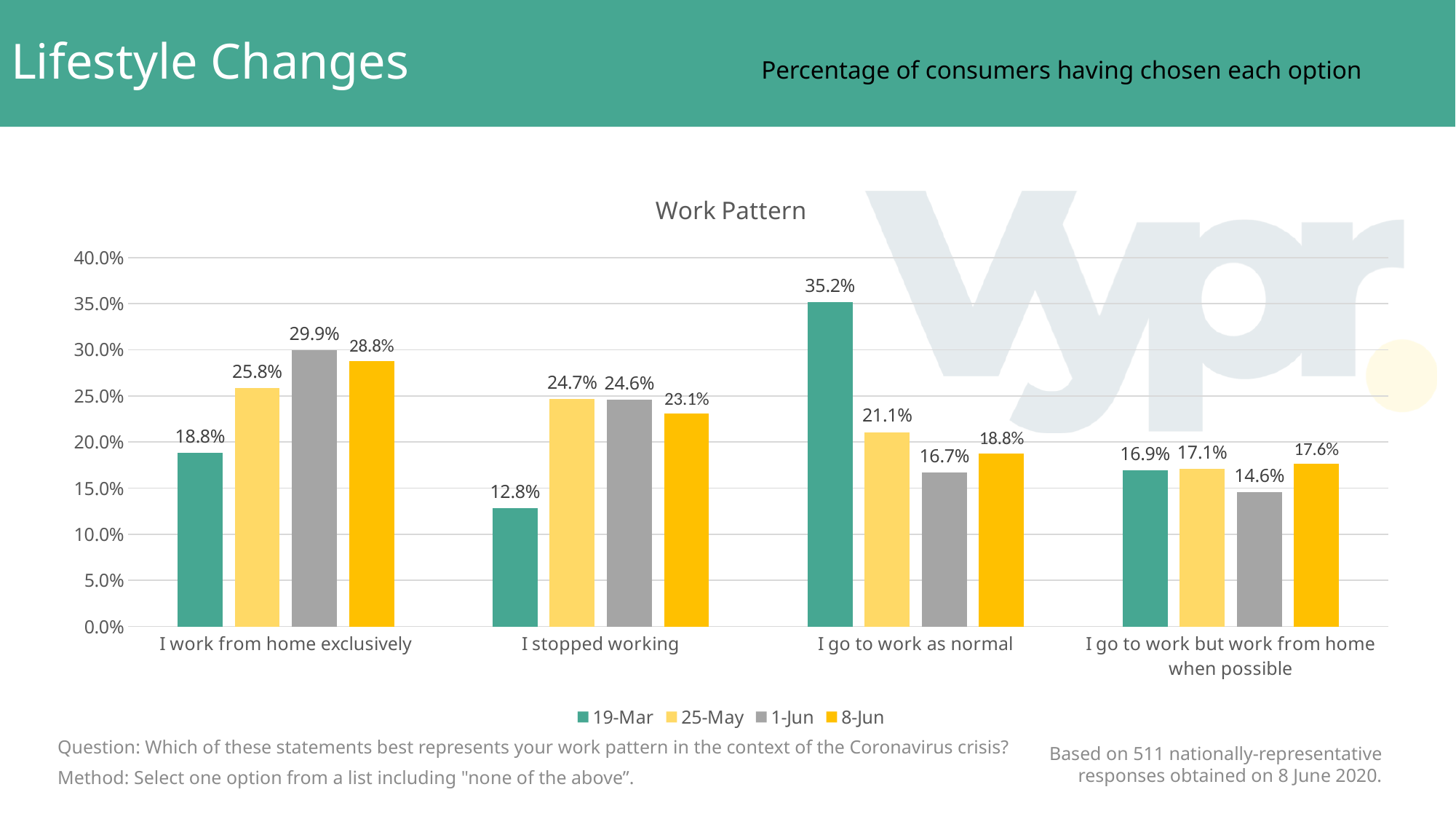
What is the value for 'I go to work as normal' in the 19-Mar series? 35.2% What is the difference between the 19-Mar and 8-Jun values for 'I go to work as normal'? 16.4% Which category has the highest value in the 19-Mar series? I go to work as normal What is the title of the chart? Work Pattern What is the value for 'I work from home exclusively' in the 1-Jun series? 29.9% Across the four dates, do the values for 'I go to work as normal' generally rise or fall from 19-Mar to 8-Jun? Fall Which is larger for 'I stopped working': the 25-May value or the 19-Mar value? 25-May What kind of chart is shown? Bar chart How many series does the legend list? 4 What is the value for 'I stopped working' in the 8-Jun series? 23.1% How many categories are shown on the x axis? 4 Which category has the lowest value in the 1-Jun series? I go to work but work from home when possible